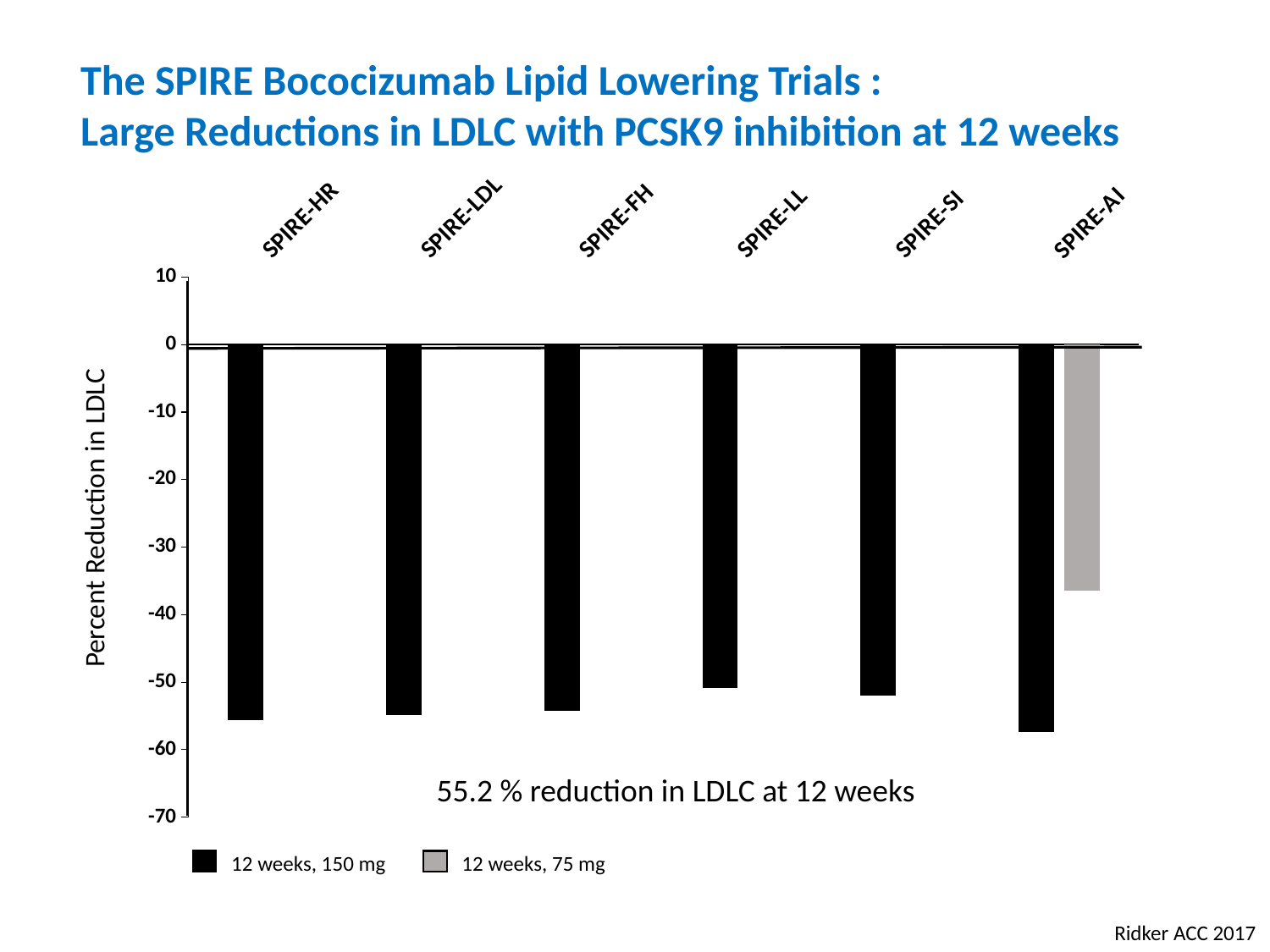
Which bar on the chart has the highest (least negative) value? SPIRE-AI, 12 weeks, 75 mg Which trial is the only one with a bar for the 12 weeks, 75 mg series? SPIRE-AI Is the value for SPIRE-LL (12 weeks, 150 mg) greater or less than -40? less What is the label of the y axis? Percent Reduction in LDLC Is the value for SPIRE-AI at 12 weeks, 75 mg greater or less than -40? greater Is the value for SPIRE-HR (12 weeks, 150 mg) greater or less than -50? less How many trials (categories) are shown along the x axis? 6 What kind of chart is shown on the slide? bar chart For SPIRE-AI, is the value for 12 weeks, 150 mg greater or less than the value for 12 weeks, 75 mg? less How many series does the legend list? 2 Which trial has the lowest (most negative) value for the 12 weeks, 150 mg series? SPIRE-AI